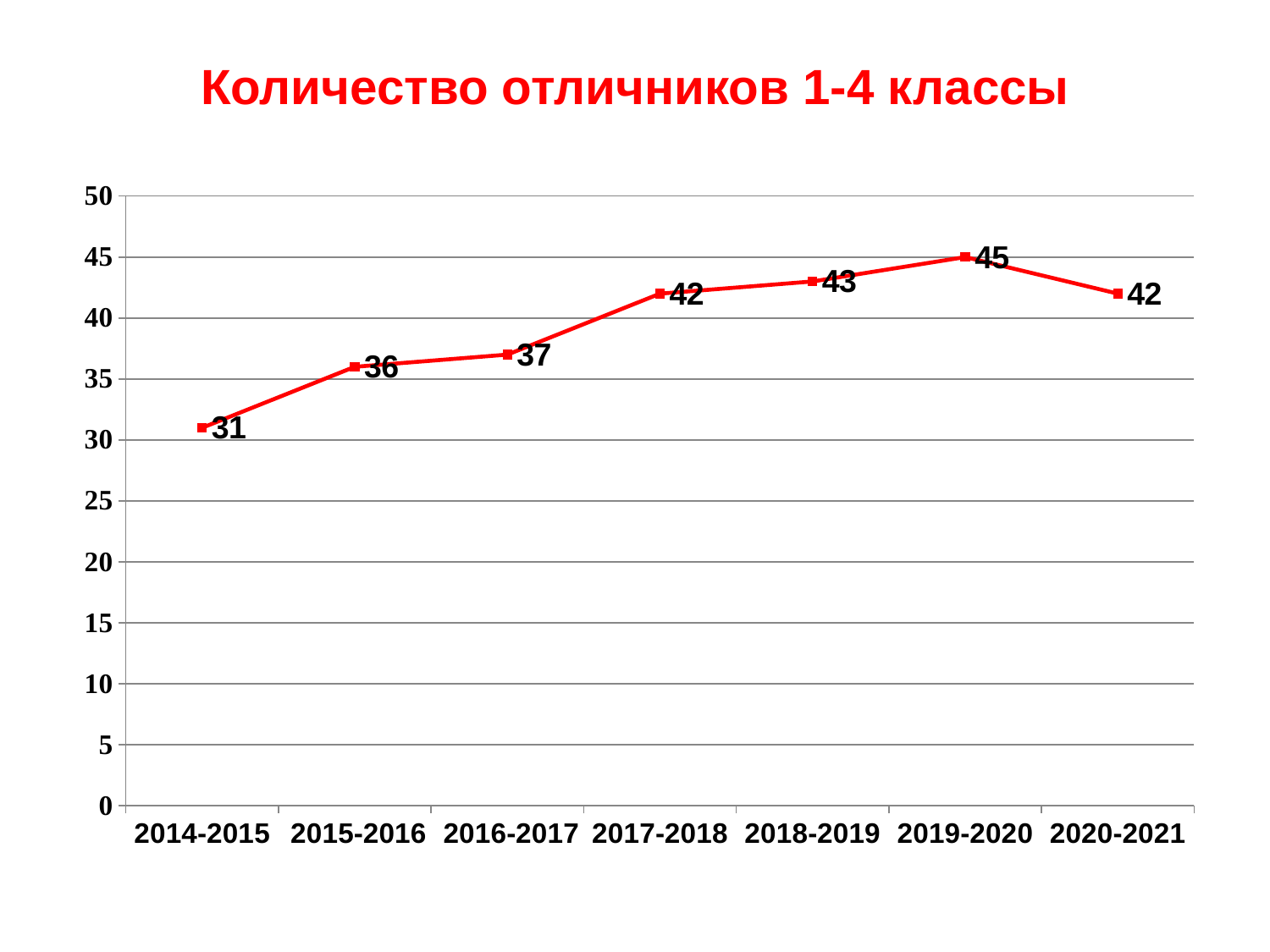
Which school year has the highest value? 2019-2020 Which is larger, the value for 2018-2019 or the value for 2015-2016? 2018-2019 What is the title of the chart? Количество отличников 1-4 классы Is the value for 2016-2017 greater or less than 40? less Which school year has the lowest value? 2014-2015 What is the difference between the values for 2017-2018 and 2016-2017? 5 How many school years are plotted on the chart? 7 What is the difference between the values for 2019-2020 and 2014-2015? 14 What kind of chart is shown on the slide? line chart What is the value for 2020-2021? 42 What is the value for 2017-2018? 42 What is the value for 2014-2015? 31